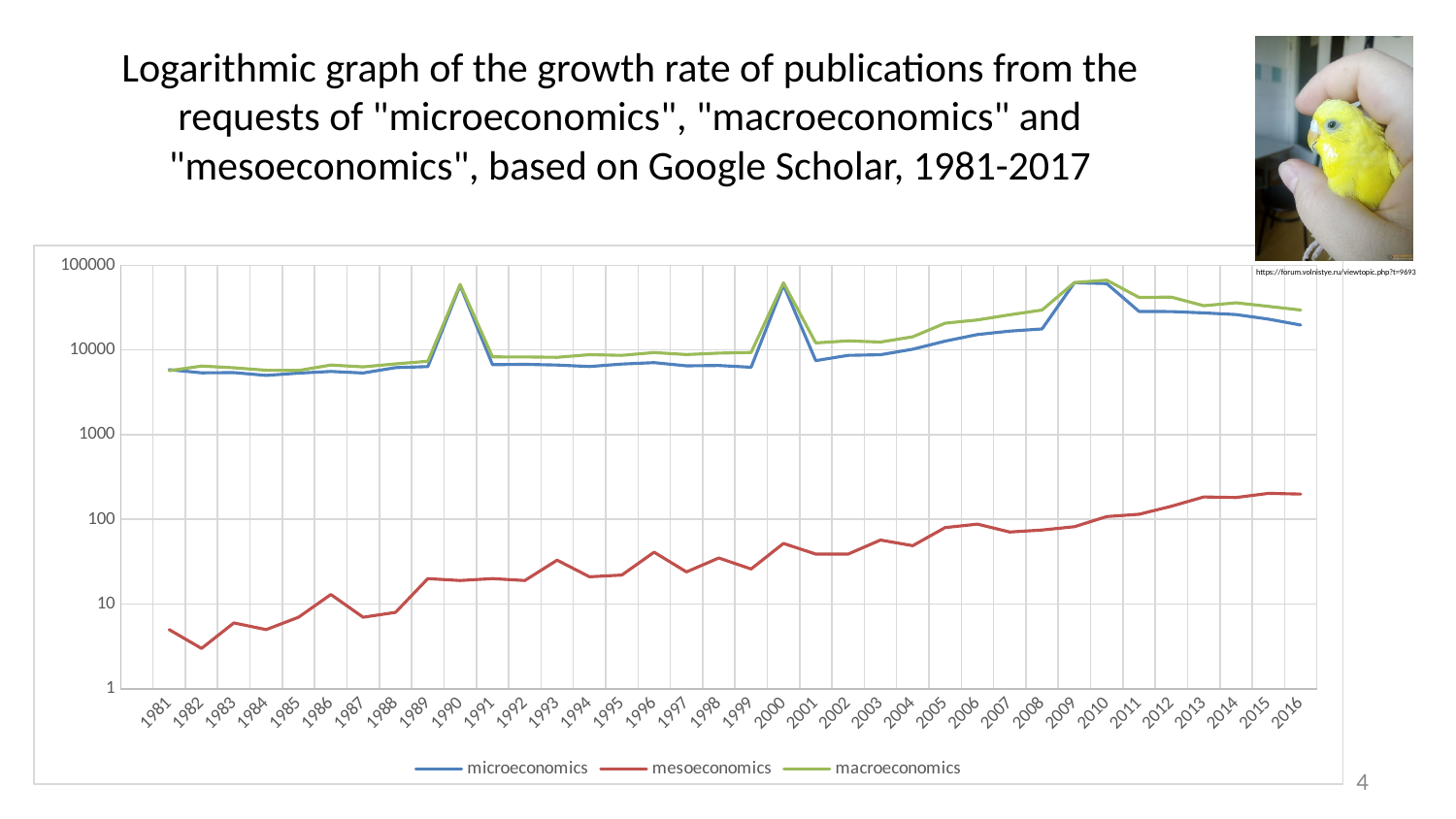
In 2000, which is larger: the value for microeconomics or the value for mesoeconomics? microeconomics Is the value for mesoeconomics in 1982 greater or less than 10? less How many series does the legend list? 3 What colour is the mesoeconomics line in the legend? red Is the value for mesoeconomics in 2016 greater or less than 100? greater How many years are plotted along the x axis? 36 Is the value for microeconomics in 1981 greater or less than 10000? less Which series has the highest value in 2016? macroeconomics Does the mesoeconomics line generally rise or fall from 1981 to 2016? rise What kind of chart is shown on the slide? line chart Which series has the lowest values across the whole period? mesoeconomics